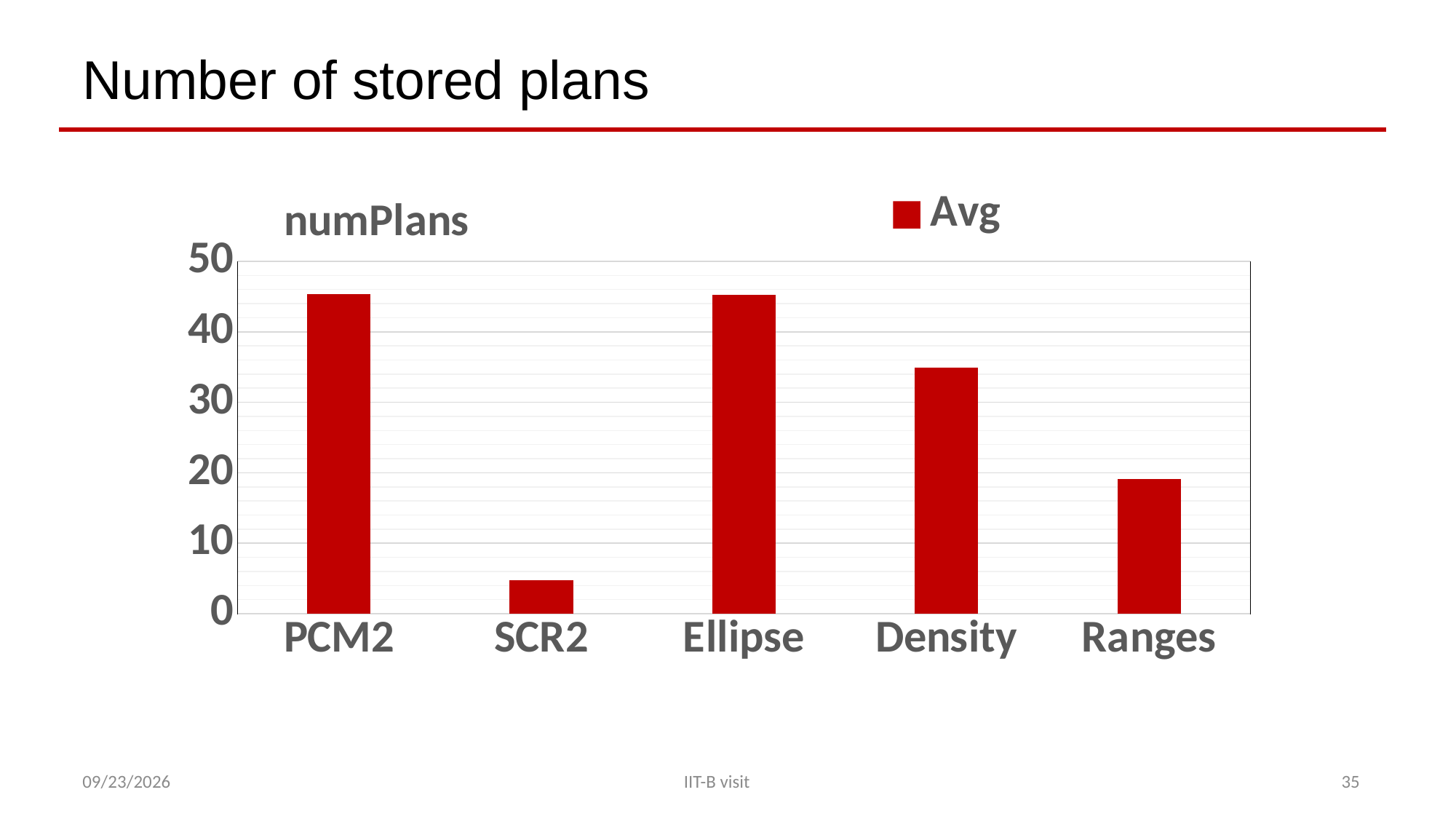
Is the value for Ranges greater or less than 10? greater Is the value for Density greater or less than 30? greater How many categories are shown on the x axis of the chart? 5 Which has the larger value, Density or Ranges? Density Is the value for PCM2 greater or less than 40? greater What series name is shown in the chart's legend? Avg Which has the larger value, SCR2 or Ranges? Ranges What is the title of the chart? numPlans Which category has the lowest value in the chart? SCR2 What kind of chart is shown on the slide? bar chart How many series does the chart's legend list? 1